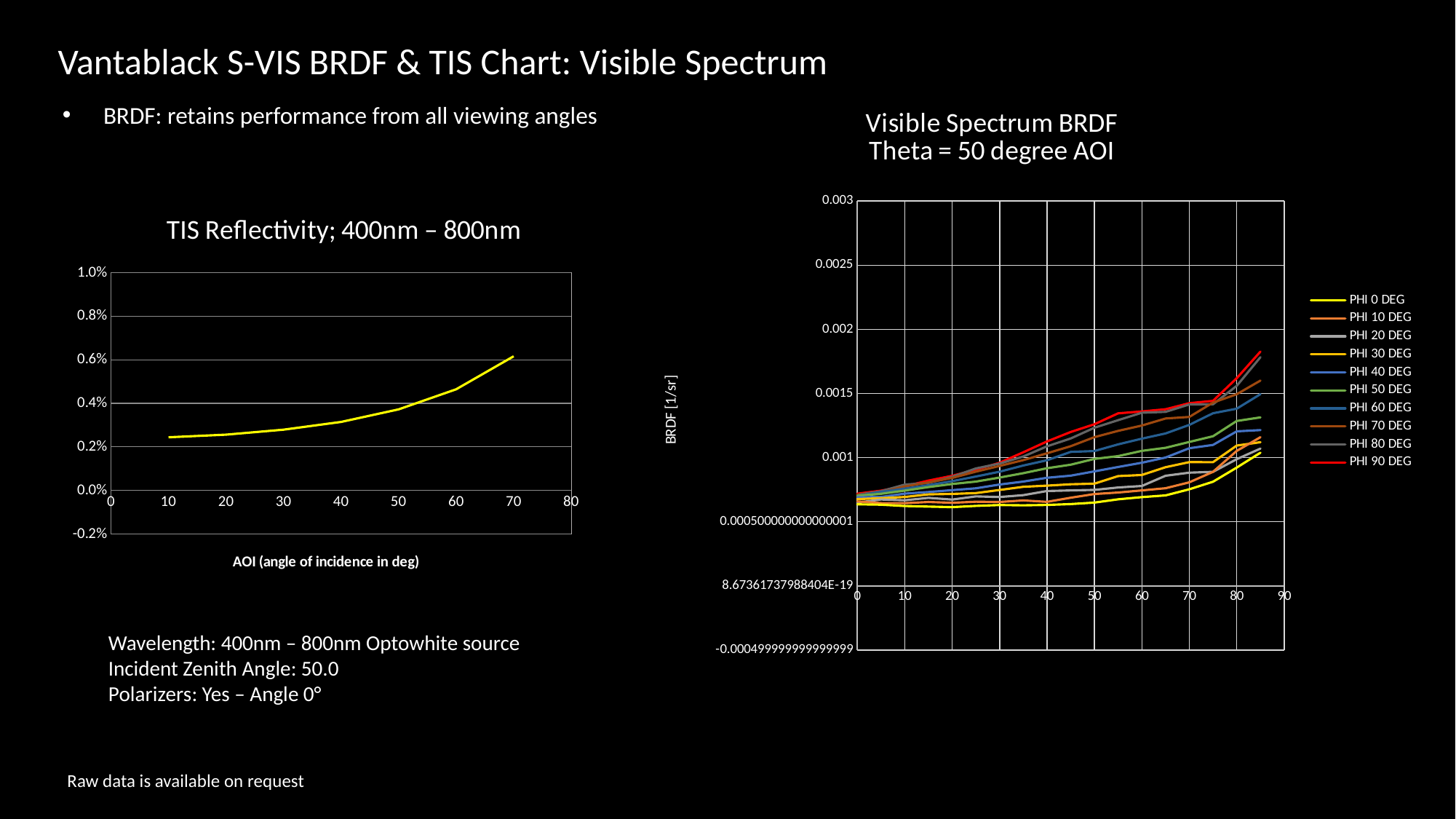
What kind of chart is the 'Visible Spectrum BRDF Theta = 50 degree AOI' chart? line chart In the 'TIS Reflectivity; 400nm – 800nm' chart, is the value at an AOI of 40 greater or less than 0.4%? less How many series does the legend of the 'Visible Spectrum BRDF Theta = 50 degree AOI' chart list? 10 In the 'TIS Reflectivity; 400nm – 800nm' chart, does the reflectivity rise or fall as the AOI increases? rise In the 'TIS Reflectivity; 400nm – 800nm' chart, is the value at an AOI of 60 greater or less than 0.4%? greater In the 'Visible Spectrum BRDF Theta = 50 degree AOI' chart, is the PHI 90 DEG value at the right end of the x axis greater or less than 0.0015? greater What is the y-axis title of the 'Visible Spectrum BRDF Theta = 50 degree AOI' chart? BRDF [1/sr] What kind of chart is the 'TIS Reflectivity; 400nm – 800nm' chart on the left? line chart What is the x-axis title of the 'TIS Reflectivity; 400nm – 800nm' chart? AOI (angle of incidence in deg) In the 'Visible Spectrum BRDF Theta = 50 degree AOI' chart, which series has the lowest values across most of the x axis? PHI 0 DEG